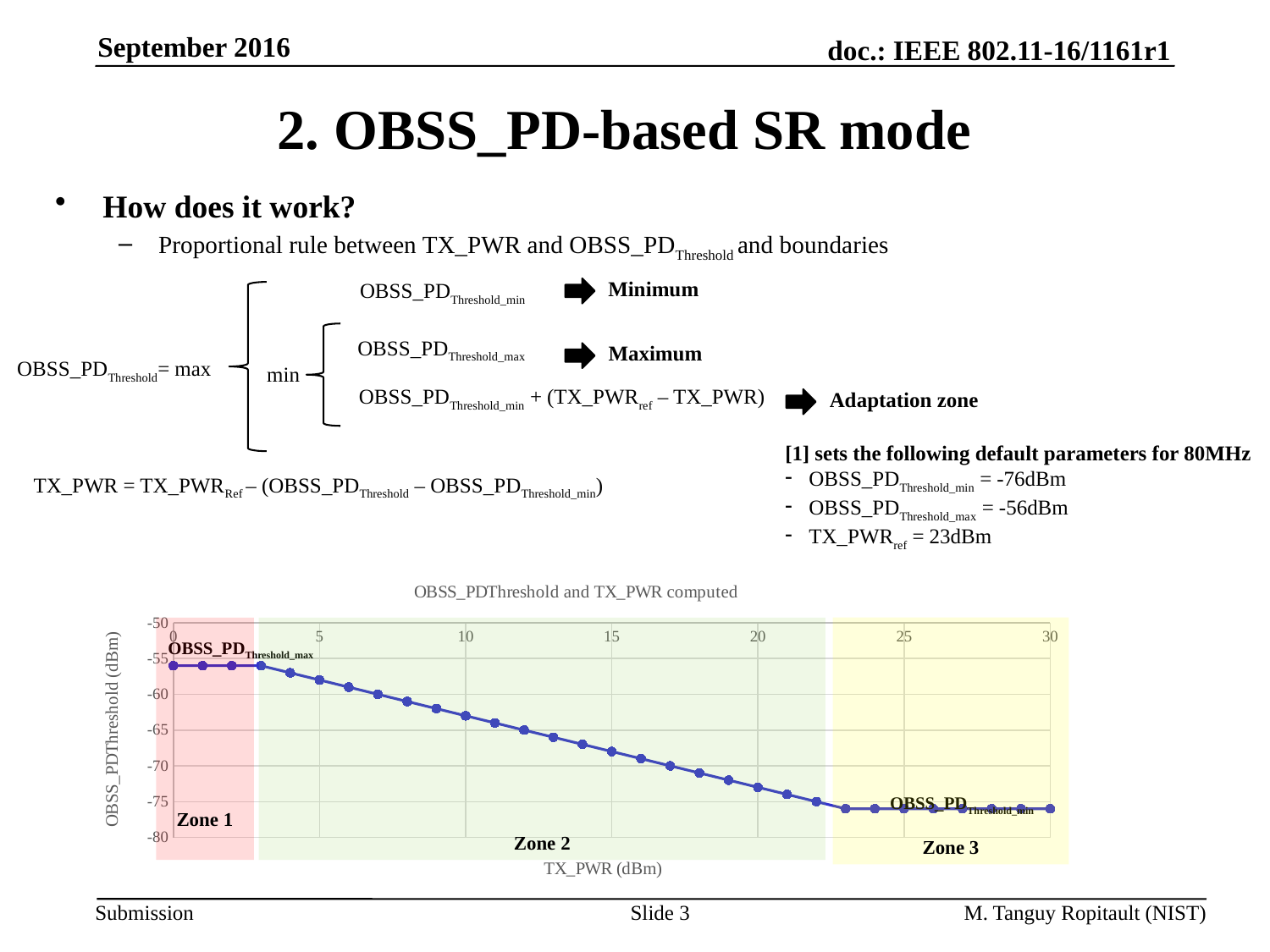
Is the value for TX_PWR = 25 greater or less than -75? less Is the value for TX_PWR = 20 greater or less than -70? less Is the value for TX_PWR = 0 greater or less than -60? greater What is the label of the x axis of the chart? TX_PWR (dBm) Do the plotted values rise or fall as TX_PWR increases from 5 to 20? fall What kind of chart is shown on the slide? line chart How many shaded zones are marked on the chart? 3 Which has the higher OBSS_PDThreshold value, TX_PWR = 5 or TX_PWR = 20? TX_PWR = 5 What is the title of the chart? OBSS_PDThreshold and TX_PWR computed